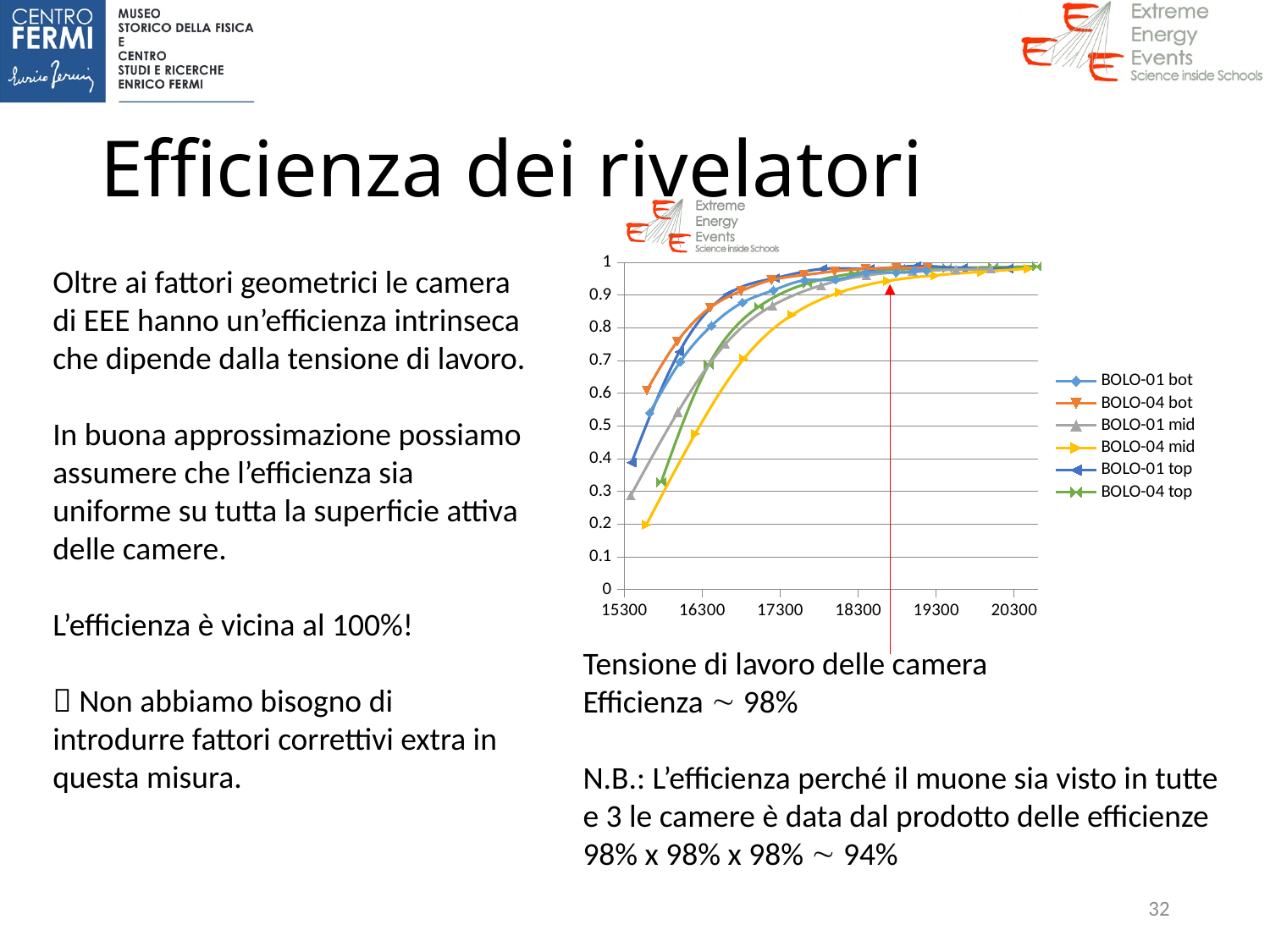
What is the maximum value shown on the y axis of the chart? 1 What is the first entry listed in the chart legend? BOLO-01 bot How many series does the chart legend list? 6 Do the efficiency values rise or fall as the working voltage increases along the x axis? rise Which series has the lowest value at the left end of the chart? BOLO-04 mid What kind of chart is shown on the slide? line chart How many tick labels are shown on the x axis of the chart? 6